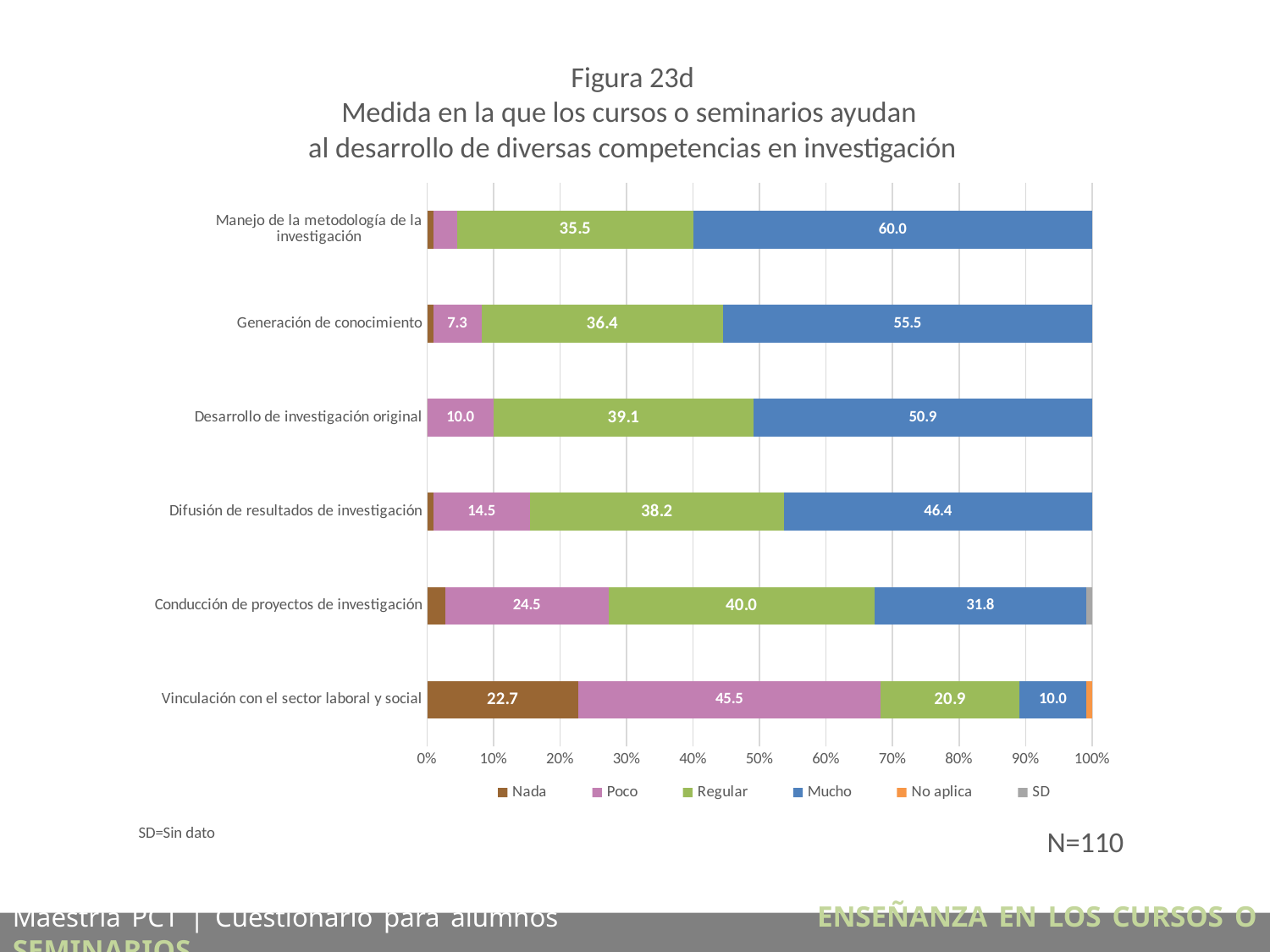
How many categories are shown on the chart? 6 Which category has the lowest "Mucho" value? Vinculación con el sector laboral y social What is the value of "Regular" for "Conducción de proyectos de investigación"? 40.0 What is the value of "Nada" for "Vinculación con el sector laboral y social"? 22.7 What is the value of "Mucho" for "Manejo de la metodología de la investigación"? 60.0 Which is larger: the "Regular" value for "Difusión de resultados de investigación" or the "Regular" value for "Manejo de la metodología de la investigación"? Difusión de resultados de investigación What is the difference between the "Mucho" values for "Generación de conocimiento" and "Desarrollo de investigación original"? 4.6 What is the value of "Poco" for "Vinculación con el sector laboral y social"? 45.5 Which category has the highest "Mucho" value? Manejo de la metodología de la investigación How many series does the legend list? 6 What is the sample size (N) stated on the slide? N=110 What kind of chart is shown on the slide? Stacked bar chart